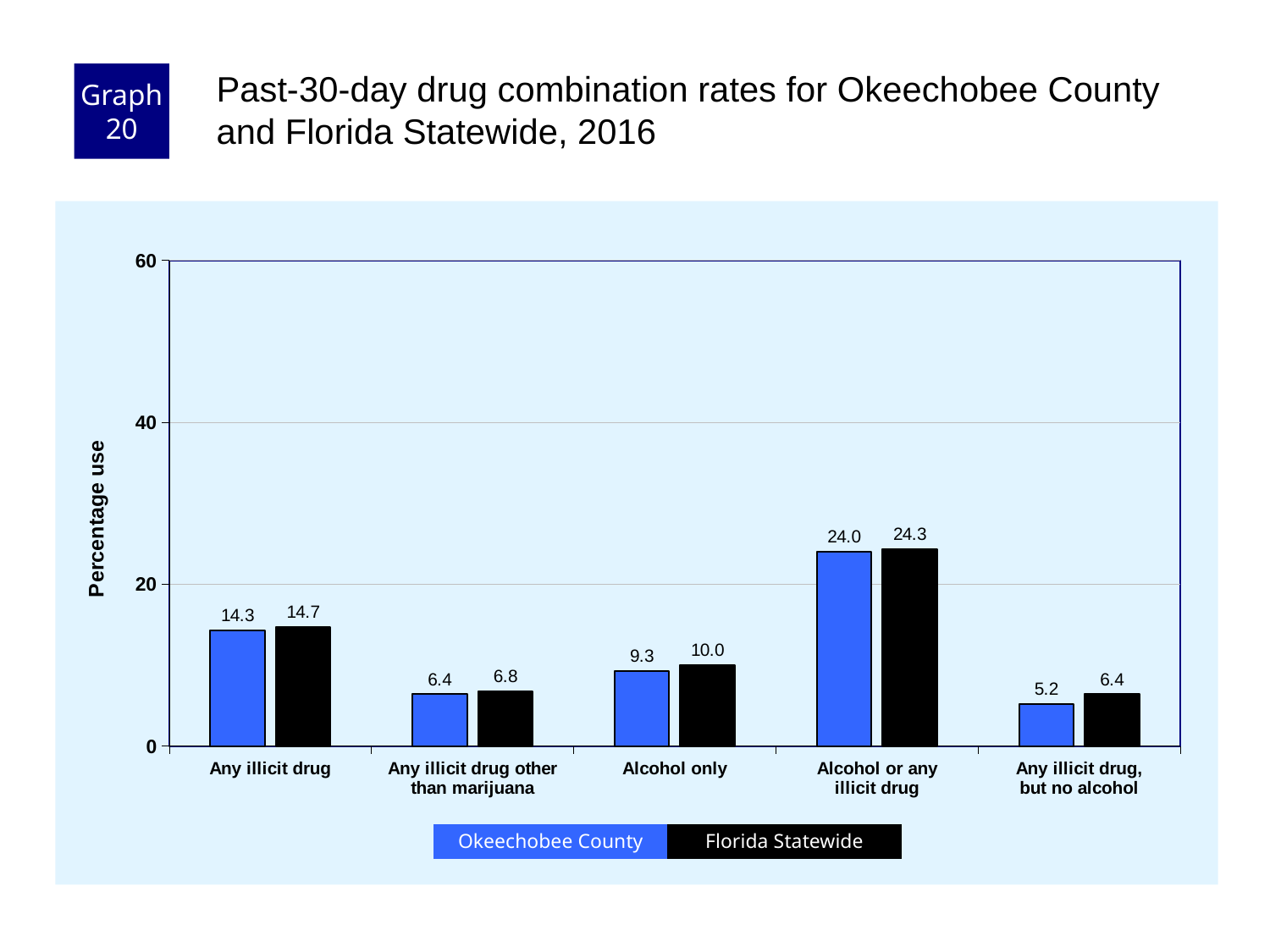
What is the difference between the Florida Statewide and Okeechobee County values for Alcohol only? 0.7 Which category has the lowest Okeechobee County value? Any illicit drug, but no alcohol Which category has the highest Florida Statewide value? Alcohol or any illicit drug How many series does the legend list? 2 What is the Florida Statewide value for Any illicit drug, but no alcohol? 6.4 What is the Okeechobee County value for Alcohol only? 9.3 What is the Okeechobee County value for Any illicit drug other than marijuana? 6.4 Which is larger for Any illicit drug: the Okeechobee County value or the Florida Statewide value? Florida Statewide How many categories are shown on the x axis? 5 Is the Okeechobee County value for Alcohol or any illicit drug greater or less than 20? greater What is the difference between the Florida Statewide and Okeechobee County values for Any illicit drug, but no alcohol? 1.2 What kind of chart is shown on the slide? Bar chart